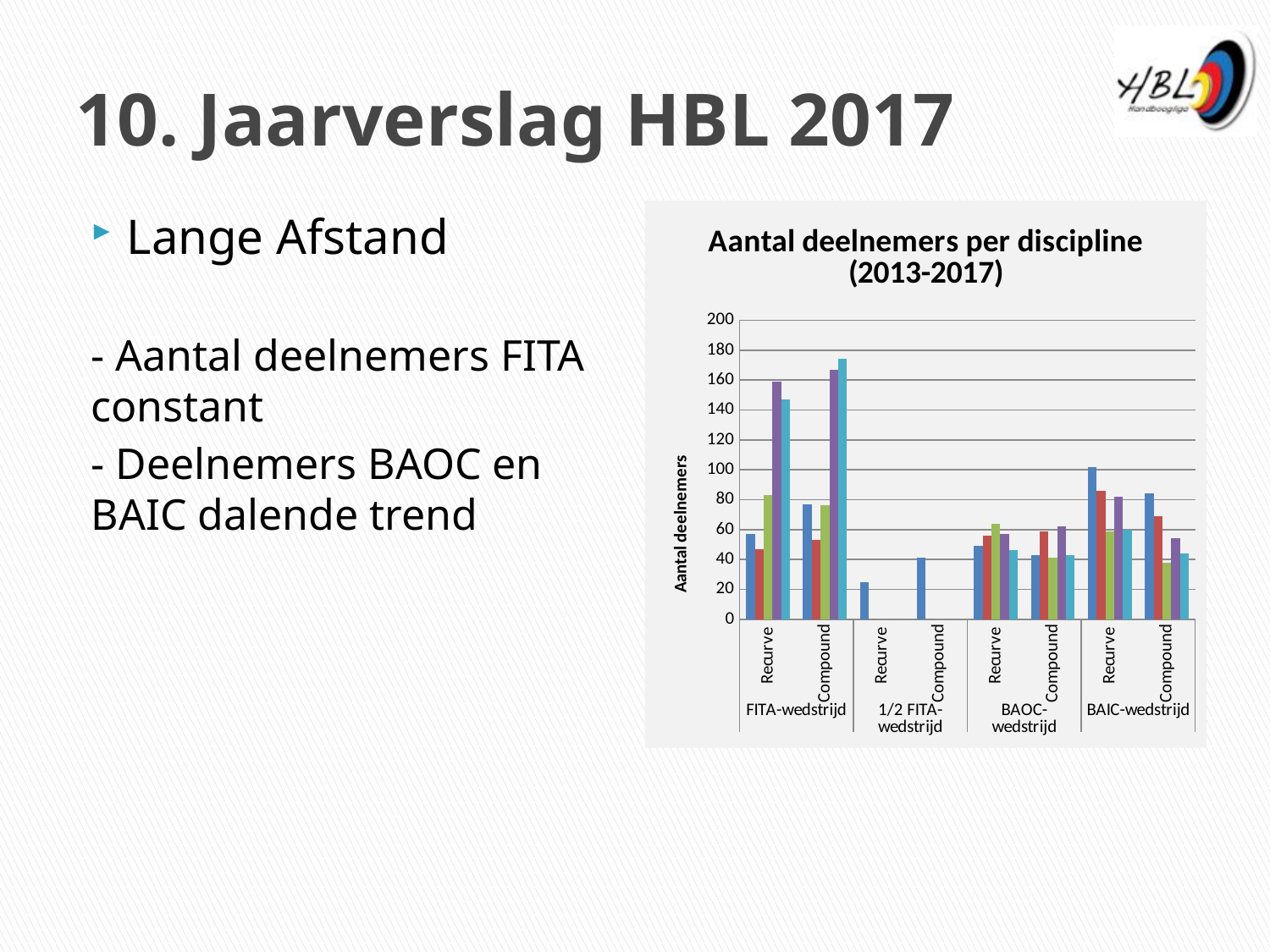
Which discipline group has the lowest bars overall in the chart? 1/2 FITA-wedstrijd Which is larger: the tallest bar for FITA-wedstrijd Compound or the tallest bar for BAIC-wedstrijd Recurve? FITA-wedstrijd Compound What kind of chart is shown on the slide? bar chart What is the title of the chart? Aantal deelnemers per discipline (2013-2017) Which category contains the tallest bar in the chart? FITA-wedstrijd Compound How many Recurve/Compound category groups are shown along the x axis of the chart? 8 Is the tallest bar for FITA-wedstrijd Compound greater or less than 160? greater What is the label of the vertical axis of the chart? Aantal deelnemers Is the tallest bar for FITA-wedstrijd Recurve greater or less than 140? greater How many discipline groups (wedstrijd types) are shown along the x axis of the chart? 4 Is the tallest bar for 1/2 FITA-wedstrijd Recurve greater or less than 40? less